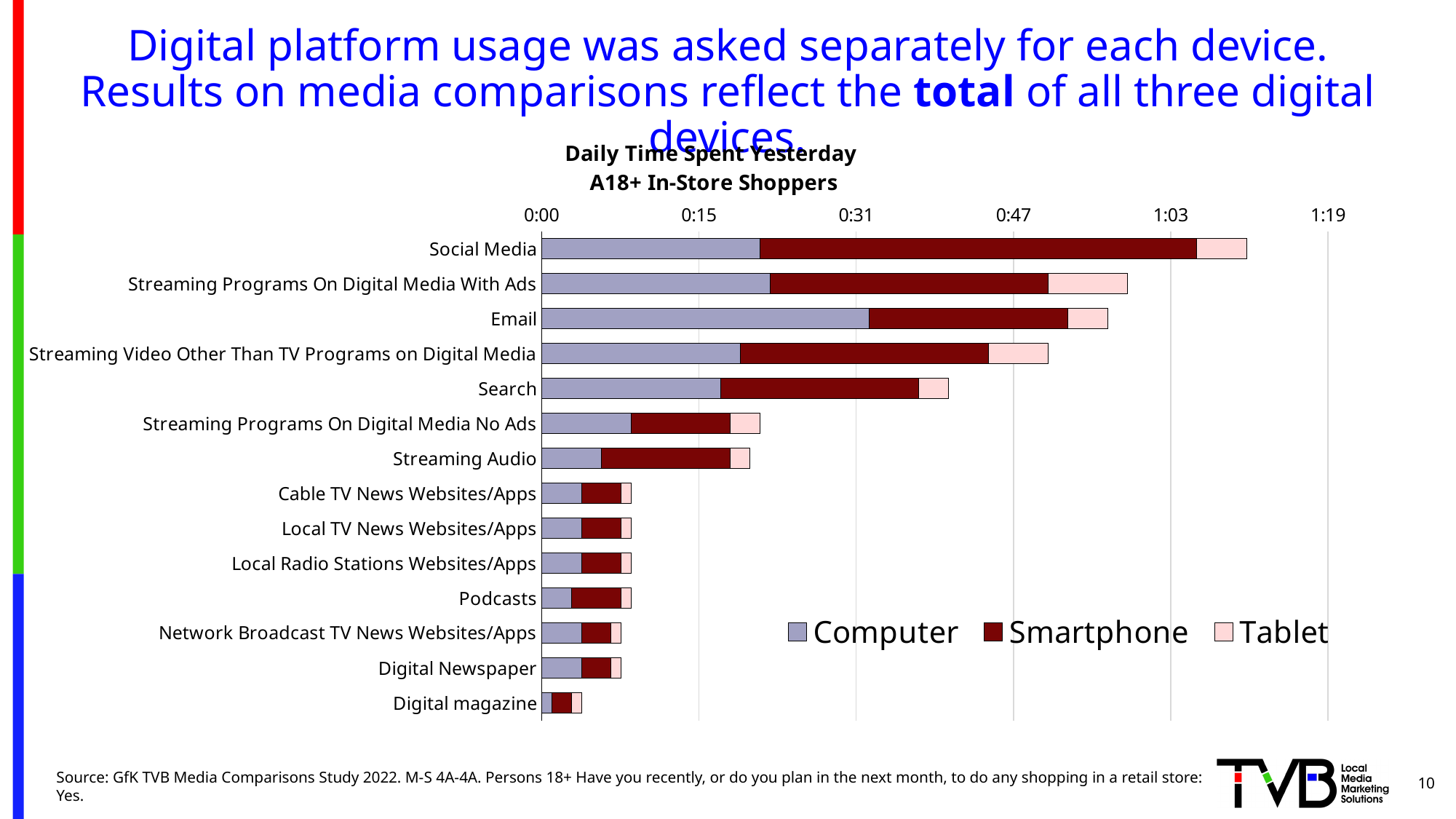
Is the total daily time spent on Social Media greater or less than 1:03? greater Is the total daily time spent on Search greater or less than 0:31? greater Is the total daily time spent on Cable TV News Websites/Apps greater or less than 0:15? less Which platform has the longest total bar for daily time spent? Social Media How many series does the legend list? 3 How many categories (digital platforms) are plotted in the chart? 14 Which has a longer total bar: Search or Streaming Audio? Search Which platform has the shortest total bar for daily time spent? Digital magazine What are the three series named in the chart legend? Computer, Smartphone, Tablet Which has a longer total bar: Streaming Programs On Digital Media With Ads or Streaming Programs On Digital Media No Ads? Streaming Programs On Digital Media With Ads What kind of chart is shown on the slide? Stacked bar chart